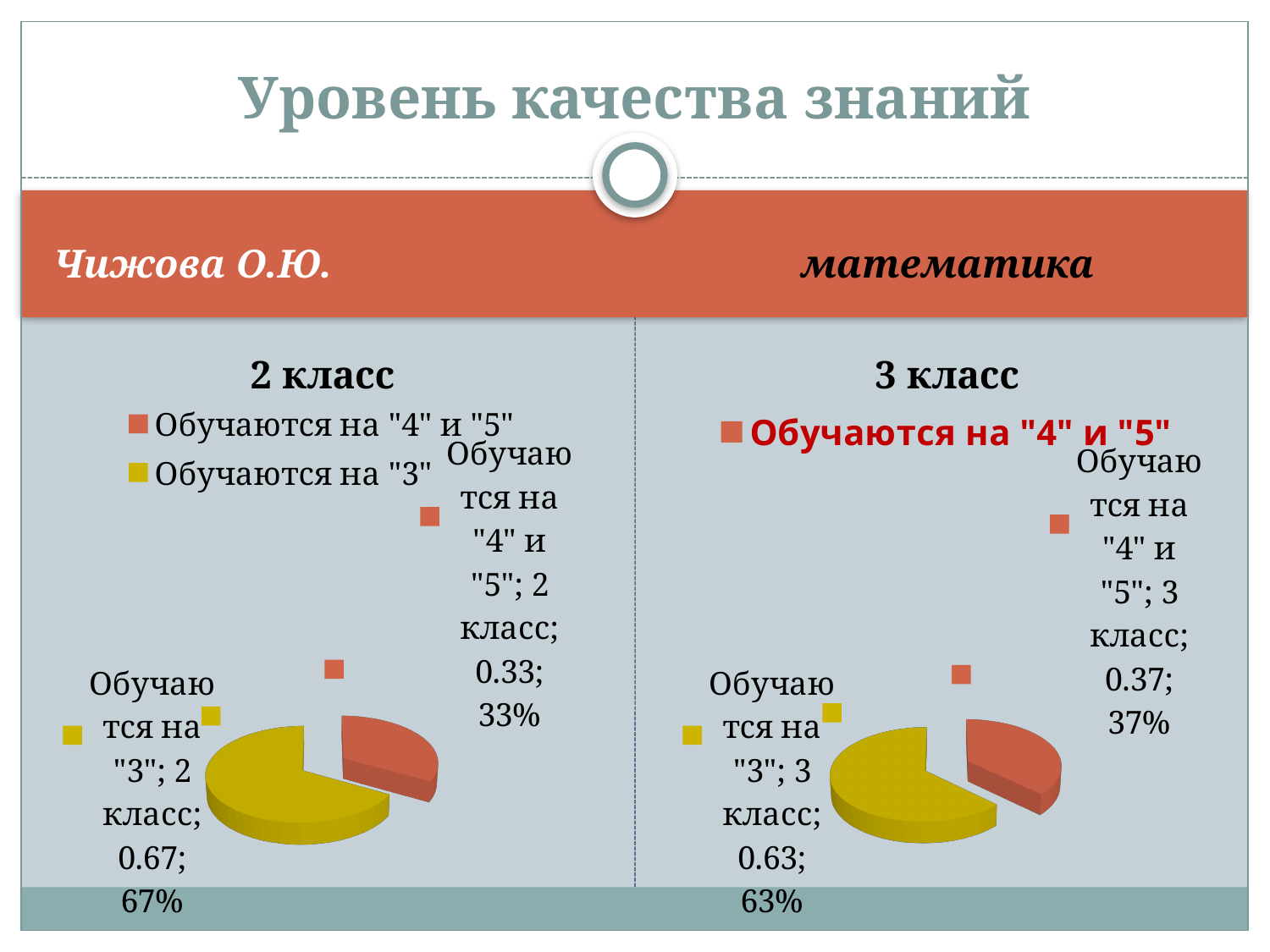
In the "3 класс" chart, what share of the pie is Обучаются на "3"? 63% In the "2 класс" chart, which slice is the largest? Обучаются на "3" In the "3 класс" chart, what share of the pie is Обучаются на "4" и "5"? 37% In the "2 класс" chart, what share of the pie is Обучаются на "4" и "5"? 33% In the "3 класс" chart, what is the difference in percentage points between Обучаются на "3" and Обучаются на "4" и "5"? 26 In the "3 класс" chart, what value is printed for Обучаются на "4" и "5"? 0.37 Which is larger: the share of Обучаются на "4" и "5" in the "2 класс" chart or in the "3 класс" chart? 3 класс How many slices does the "2 класс" pie chart have? 2 What kind of chart is the "2 класс" chart? pie chart In the "3 класс" chart, which slice is the smallest? Обучаются на "4" и "5" In the "2 класс" chart, what value is printed for Обучаются на "3"? 0.67